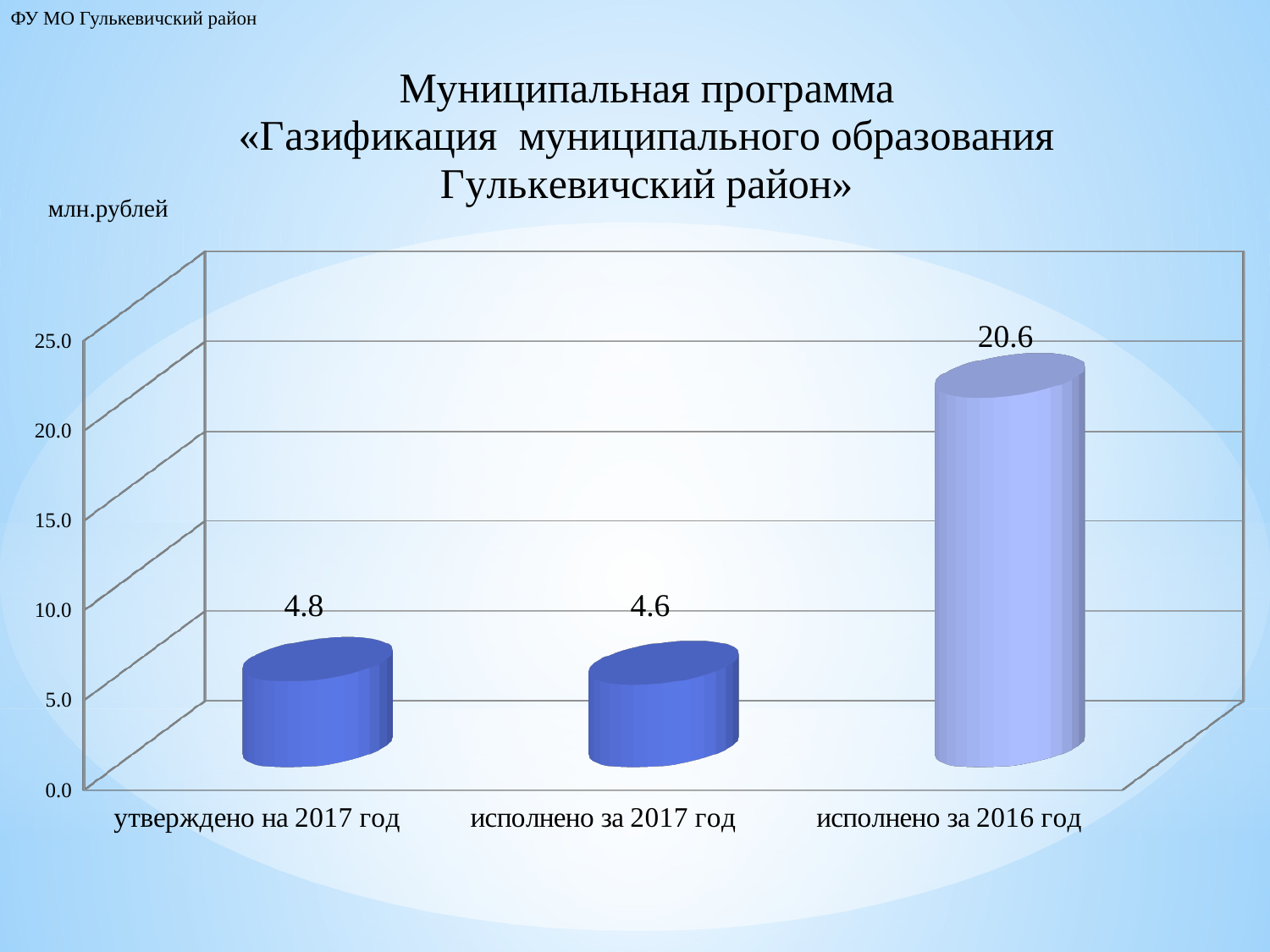
Which category has the lowest value? исполнено за 2017 год What is the difference between the values for «утверждено на 2017 год» and «исполнено за 2017 год»? 0.2 Which is larger: the value for «утверждено на 2017 год» or for «исполнено за 2016 год»? исполнено за 2016 год What is the value for «утверждено на 2017 год»? 4.8 What is the value for «исполнено за 2016 год»? 20.6 Which category has the highest value? исполнено за 2016 год What is the value for «исполнено за 2017 год»? 4.6 What unit is indicated for the values on the chart? млн.рублей What kind of chart is shown on the slide? bar chart What is the difference between the values for «исполнено за 2016 год» and «исполнено за 2017 год»? 16.0 Is the value for «исполнено за 2016 год» greater or less than 20.0? greater How many categories are shown on the chart? 3